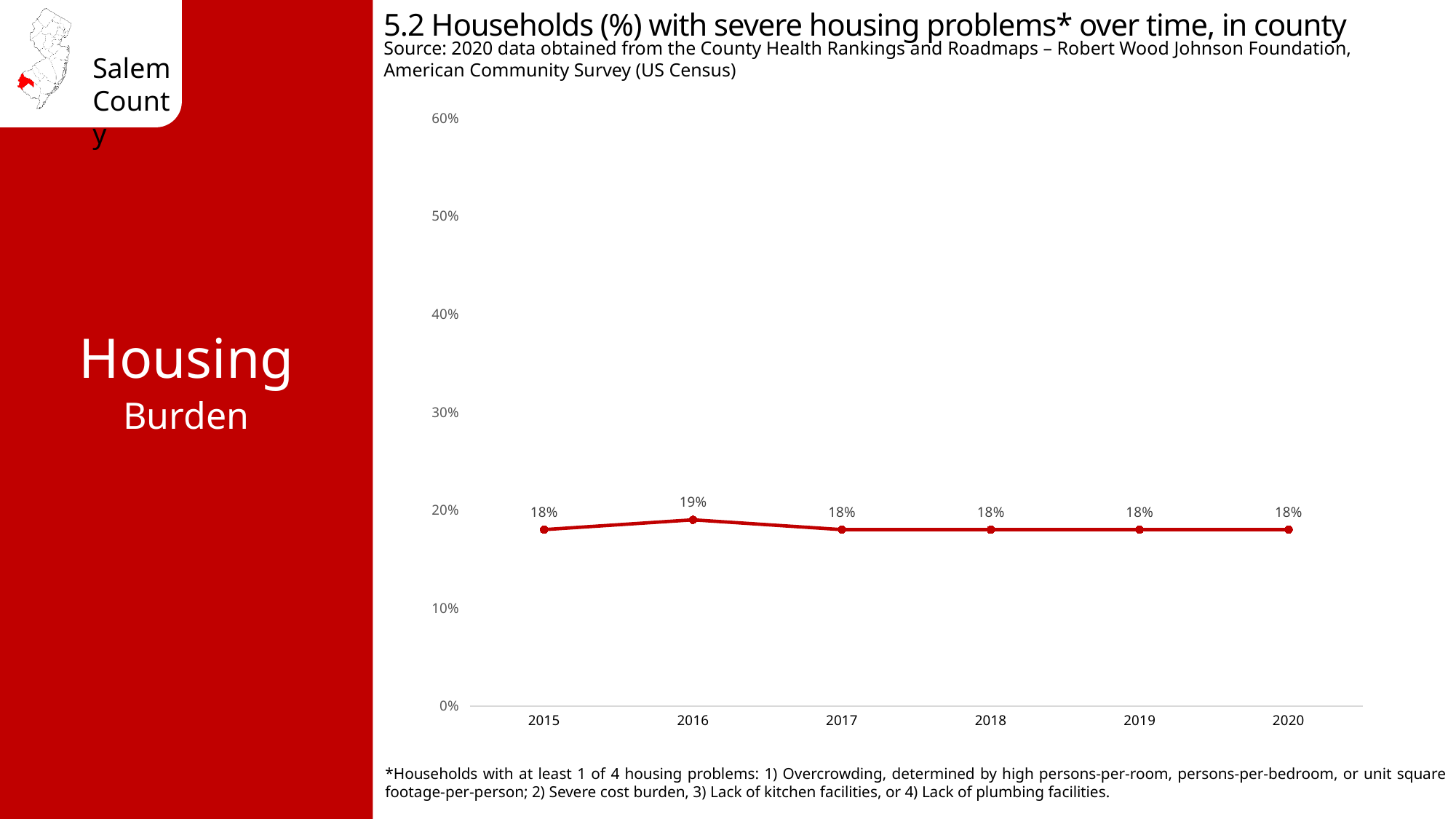
Is the value for 2018 greater or less than 20%? less What percentage of households had severe housing problems in 2015? 18% What percentage of households had severe housing problems in 2020? 18% What percentage of households had severe housing problems in 2016? 19% What is the difference between the 2016 value and the 2017 value? 1% What kind of chart is shown on the slide? line chart What is the title of the chart? 5.2 Households (%) with severe housing problems* over time, in county What is the highest value shown on the vertical axis? 60% Which year has the highest percentage of households with severe housing problems? 2016 Does the percentage of households with severe housing problems change between 2017 and 2020? No, it stays at 18% Is the value for 2016 greater or less than 10%? greater How many years are plotted on the chart? 6